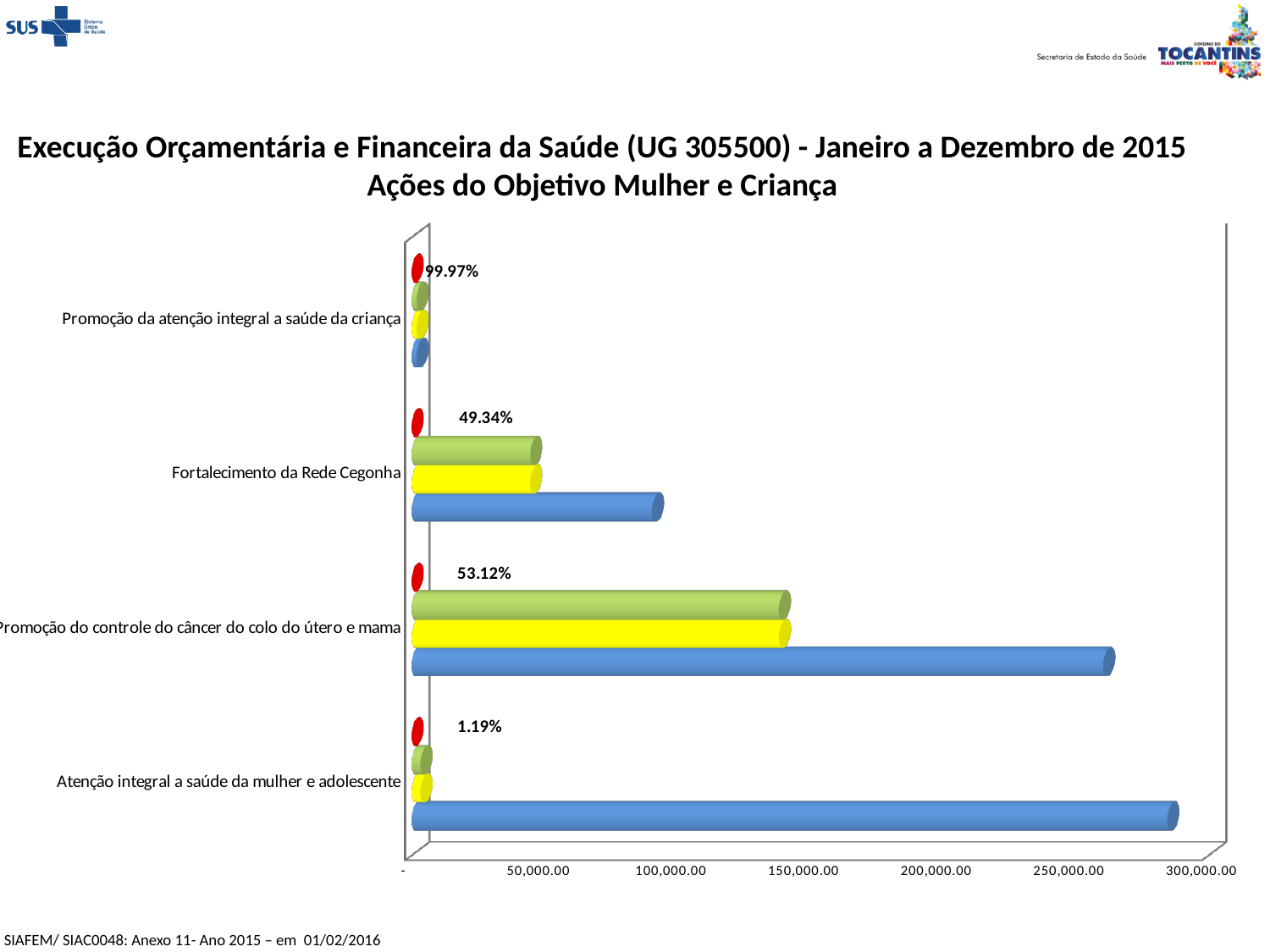
Which category has the longer blue bar: Atenção integral a saúde da mulher e adolescente or Promoção do controle do câncer do colo do útero e mama? Atenção integral a saúde da mulher e adolescente What percentage is shown for Fortalecimento da Rede Cegonha? 49.34% How many categories are shown on the chart? 4 Which category has the lowest percentage label? Atenção integral a saúde da mulher e adolescente What is the difference between the percentage for Promoção do controle do câncer do colo do útero e mama and the percentage for Fortalecimento da Rede Cegonha? 3.78% Which has the larger percentage label: Fortalecimento da Rede Cegonha or Promoção do controle do câncer do colo do útero e mama? Promoção do controle do câncer do colo do útero e mama What percentage is shown for Promoção da atenção integral a saúde da criança? 99.97% What percentage is shown for Atenção integral a saúde da mulher e adolescente? 1.19% What kind of chart is shown on the slide? Bar chart Which category has the highest percentage label? Promoção da atenção integral a saúde da criança Is the value of the blue bar for Atenção integral a saúde da mulher e adolescente greater or less than 250,000.00? greater Is the value of the blue bar for Fortalecimento da Rede Cegonha greater or less than 100,000.00? less